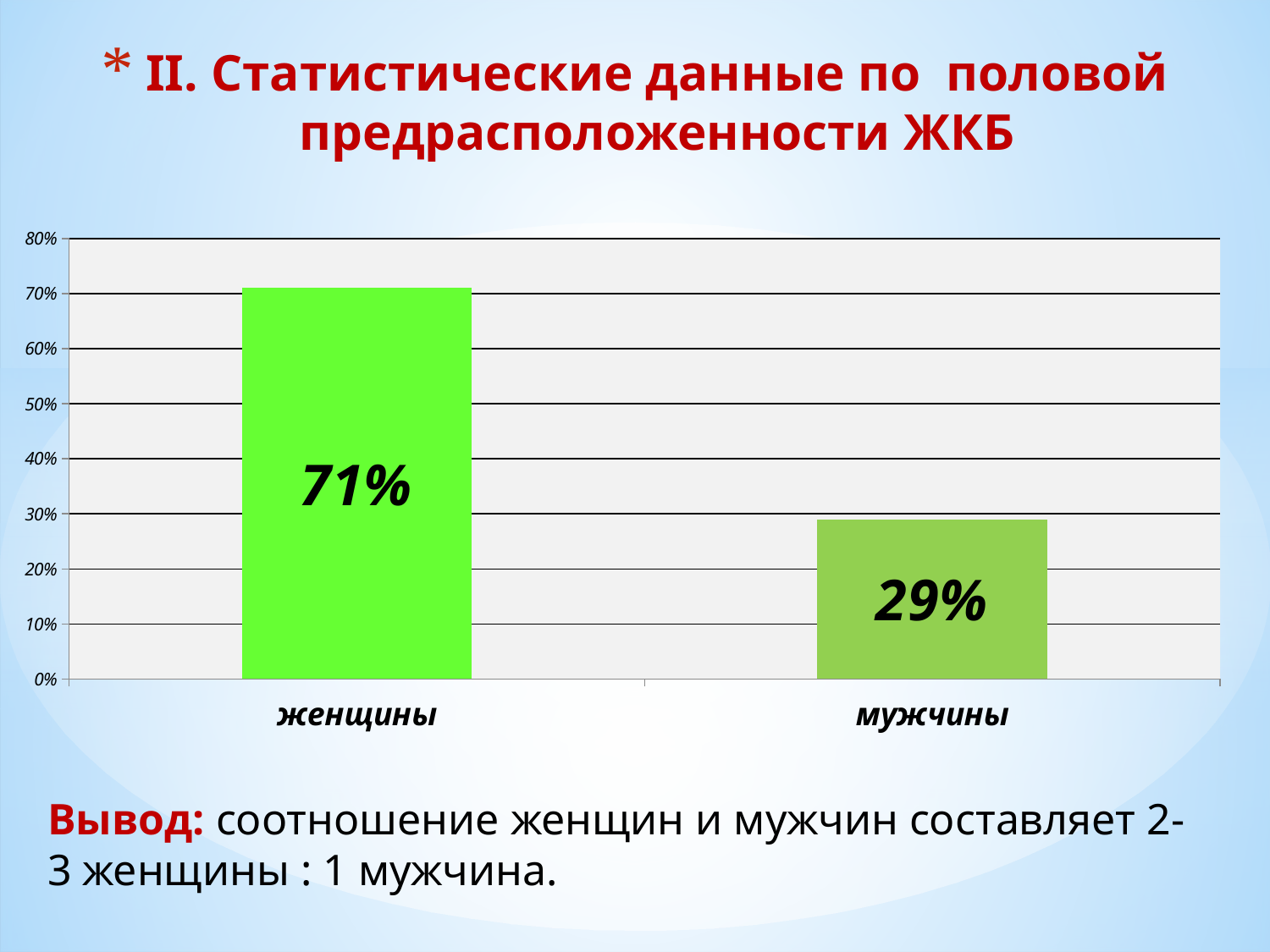
What is the difference between the values for женщины and мужчины? 42% What kind of chart is shown on the slide? bar chart Is the value for мужчины greater or less than 30%? less Which category has the highest value? женщины What is the total of the two bars' values? 100% What is the value for мужчины? 29% What is the highest value shown on the vertical axis? 80% Is the value for женщины greater or less than 60%? greater What is the value for женщины? 71% Which category has the lowest value? мужчины How many categories are shown in the chart? 2 Which is larger, the value for женщины or the value for мужчины? женщины